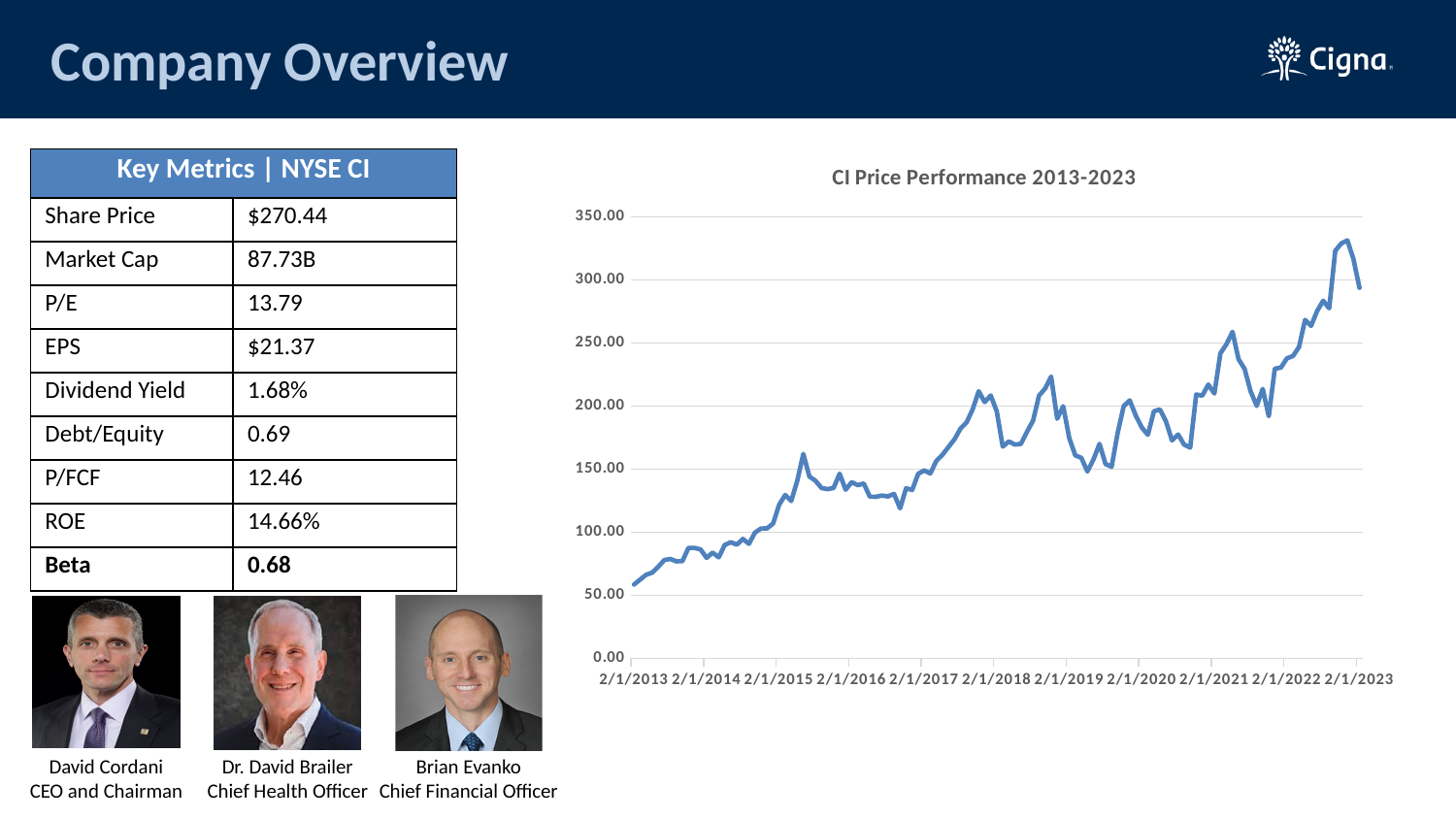
What kind of chart is shown on the slide? line chart How many lines are plotted on the chart? 1 Is the value at 2/1/2022 greater or less than 200.00? greater Overall, does the plotted price rise or fall from 2/1/2013 to 2/1/2023? rise Is the highest point on the line greater or less than 300.00? greater What is the highest value labelled on the y axis? 350.00 Is the value at 2/1/2015 greater or less than 100.00? greater How many date labels are shown on the x axis? 11 What is the title of the chart? CI Price Performance 2013-2023